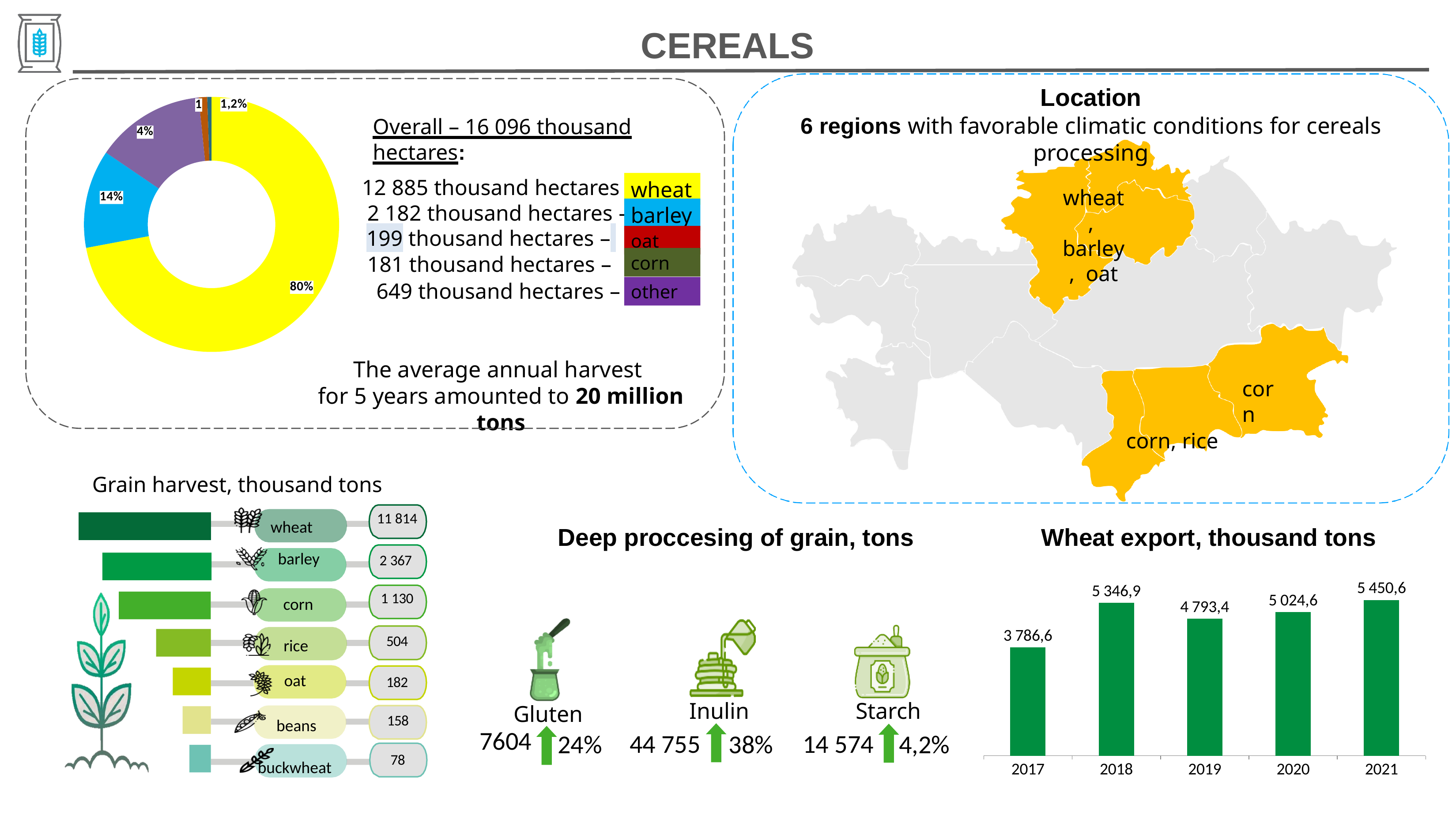
In the Wheat export, thousand tons chart, which is larger, the value for 2018 or the value for 2020? 2018 In the Grain harvest, thousand tons chart, which crop has the lowest value? buckwheat How many crops are shown in the Grain harvest, thousand tons chart? 7 In the donut chart of cereal area, what share does barley have? 14% What kind of chart is the Wheat export, thousand tons chart? bar chart In the Wheat export, thousand tons chart, what is the difference between the 2021 and 2017 values? 1 664,0 In the Grain harvest, thousand tons chart, what is the value for corn? 1 130 In the donut chart of cereal area, which crop has the largest share? wheat In the Wheat export, thousand tons chart, which year has the lowest value? 2017 How many years are shown in the Wheat export, thousand tons chart? 5 In the Wheat export, thousand tons chart, what is the value for 2019? 4 793,4 In the Wheat export, thousand tons chart, which year has the highest value? 2021